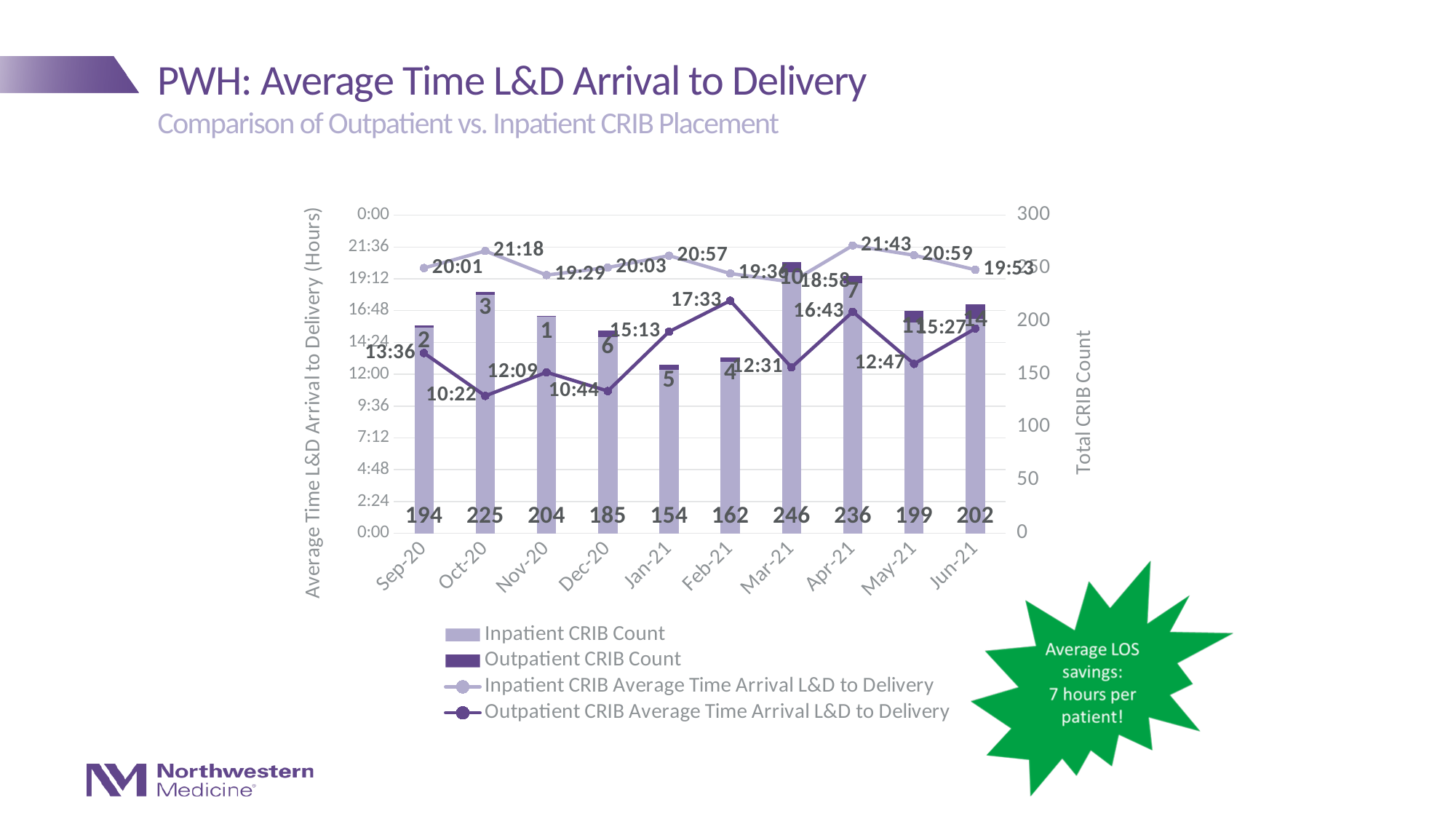
What is the difference between the Inpatient CRIB Count for Oct-20 and Sep-20? 31 How many months are shown on the x axis? 10 Which month has the highest Inpatient CRIB Count? Mar-21 How many series does the legend list? 4 Which month has the larger Inpatient CRIB Count, Apr-21 or May-21? Apr-21 Which month has the lowest Inpatient CRIB Count? Jan-21 What is the Inpatient CRIB Average Time Arrival L&D to Delivery for Apr-21? 21:43 Which month has the lowest Outpatient CRIB Average Time Arrival L&D to Delivery? Oct-20 What is the Outpatient CRIB Average Time Arrival L&D to Delivery for Feb-21? 17:33 What is the Outpatient CRIB Count for Dec-20? 6 What is the Inpatient CRIB Count for Mar-21? 246 What is the label of the right-hand vertical axis? Total CRIB Count